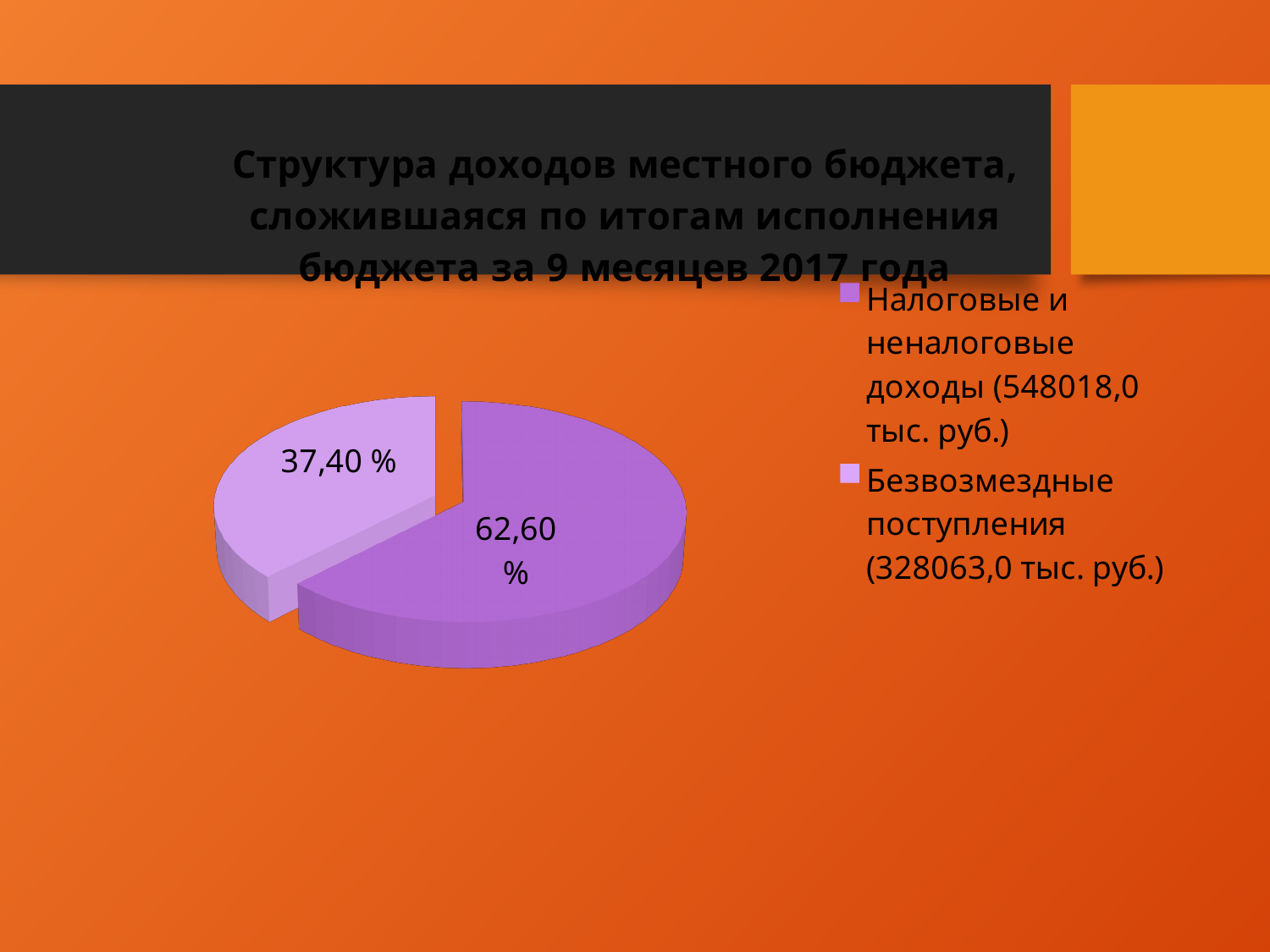
Which category has the smallest slice of the pie? Безвозмездные поступления What is the difference in percentage points between the two slices of the pie? 25,20 % What amount in thousand rubles is given in the legend for "Налоговые и неналоговые доходы"? 548018,0 тыс. руб. What share of the pie does "Безвозмездные поступления" take? 37,40 % How many entries does the legend list? 2 What share of the pie does "Налоговые и неналоговые доходы" take? 62,60 % What is the title of the chart on the slide? Структура доходов местного бюджета, сложившаяся по итогам исполнения бюджета за 9 месяцев 2017 года Which is larger: the slice for "Налоговые и неналоговые доходы" or the slice for "Безвозмездные поступления"? Налоговые и неналоговые доходы Which category has the largest slice of the pie? Налоговые и неналоговые доходы What kind of chart is shown on the slide? Pie chart How many slices does the pie chart have? 2 What amount in thousand rubles is given in the legend for "Безвозмездные поступления"? 328063,0 тыс. руб.